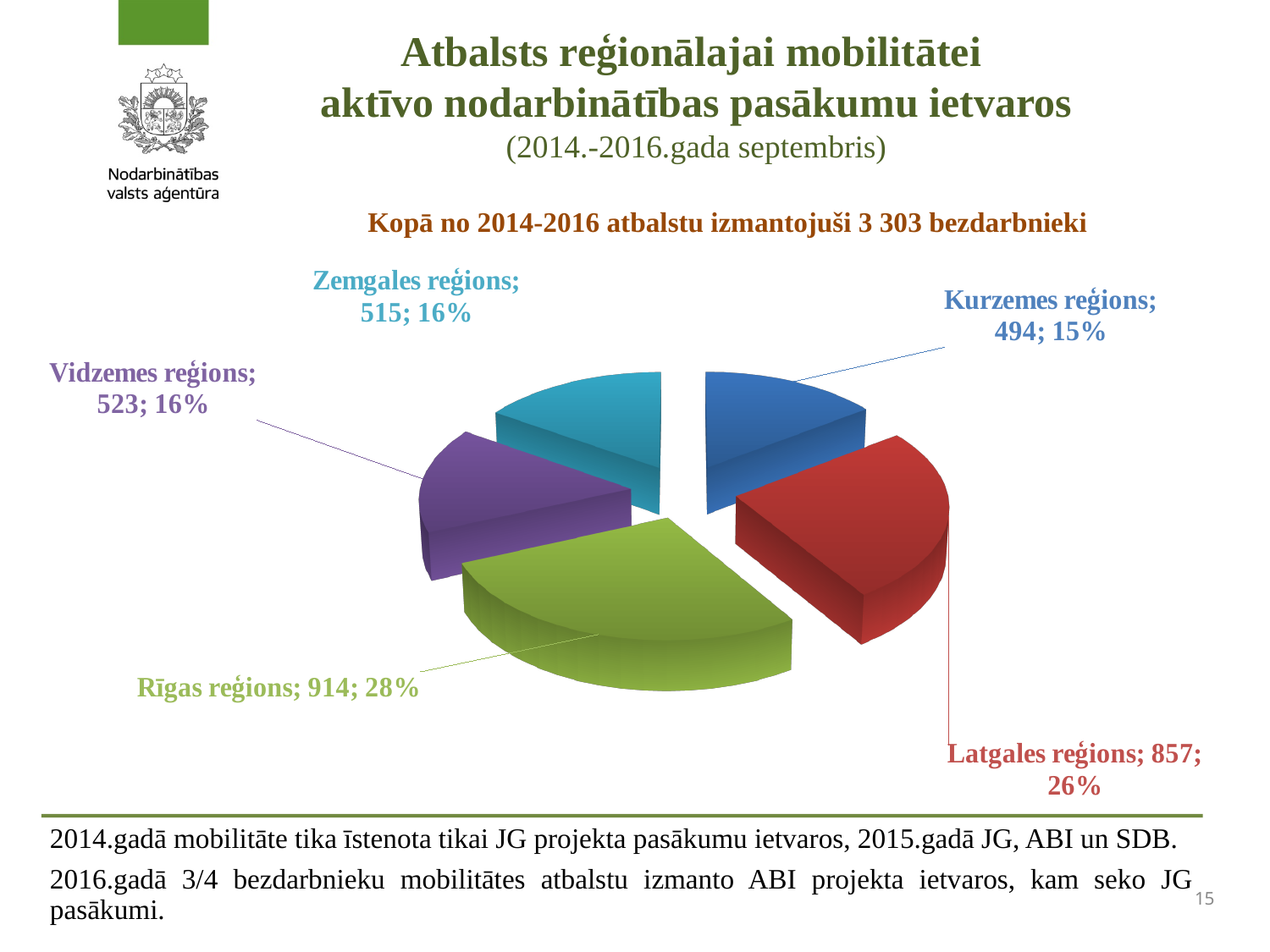
Which region has the smallest slice of the pie? Kurzemes reģions What is the value for Kurzemes reģions? 494 How many regions (slices) does the pie chart show? 5 What is the difference between the values for Rīgas reģions and Latgales reģions? 57 What colour is the slice for Rīgas reģions? Green Which is larger, the value for Vidzemes reģions or Zemgales reģions? Vidzemes reģions What share of the pie does Vidzemes reģions represent? 16% What kind of chart is shown on the slide? Pie chart What is the value for Latgales reģions? 857 What is the value for Rīgas reģions? 914 Which region has the largest slice of the pie? Rīgas reģions What share of the pie does Latgales reģions represent? 26%